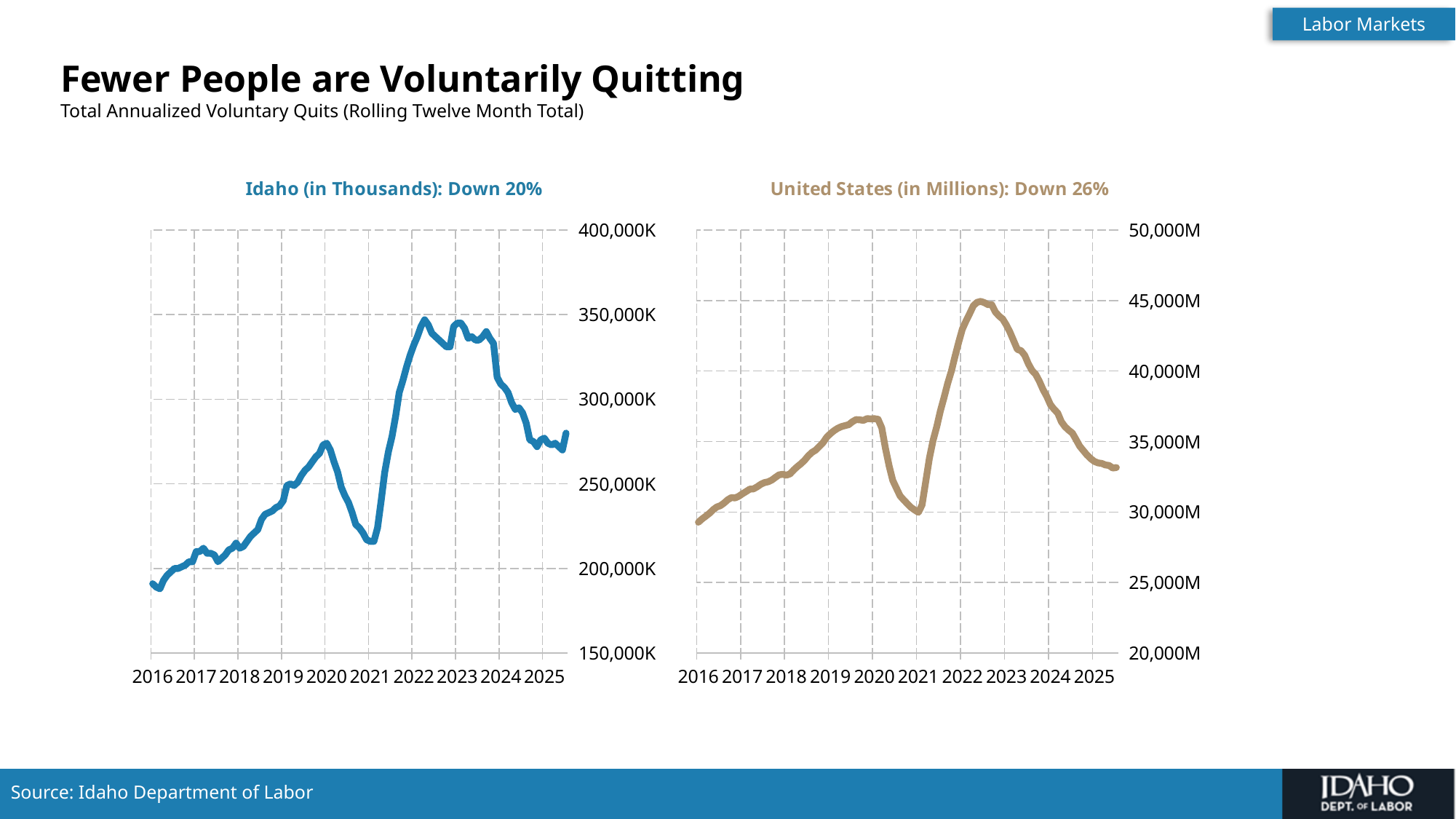
What kind of chart is the United States chart on the right? line chart In the United States chart, do values rise or fall from 2016 to 2019? rise In the Idaho chart, is the value at the end of the series in 2025 greater or less than 300,000K? less How many percentage points larger is the decline stated in the United States chart title than in the Idaho chart title? 6 In the Idaho chart, is the peak value around 2022 greater or less than 300,000K? greater In the United States chart, is the value at the end of the series in 2025 greater or less than 35,000M? less According to its title, by what percentage are voluntary quits down in the United States chart? Down 26% Which chart shows the larger percentage decline in its title, Idaho or United States? United States What kind of chart is the Idaho chart on the left? line chart According to its title, by what percentage are voluntary quits down in the Idaho chart? Down 20%